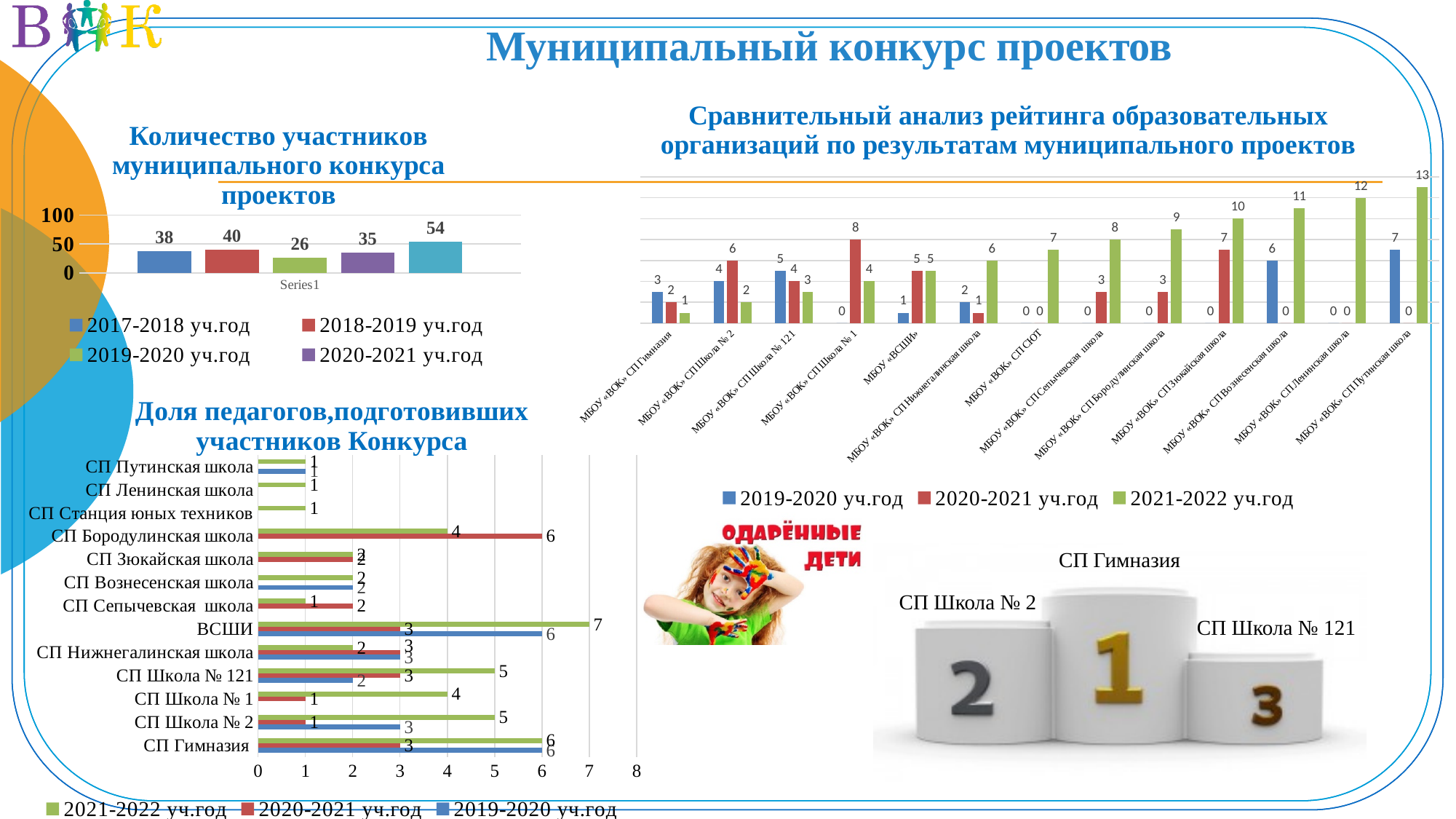
In the chart 'Сравнительный анализ рейтинга образовательных организаций', which organisation has the highest value for 2021-2022 уч.год? МБОУ «ВОК» СП Путинская школа In the chart 'Количество участников муниципального конкурса проектов', what is the value for 2019-2020 уч.год? 26 In the chart 'Сравнительный анализ рейтинга образовательных организаций', does the 2021-2022 уч.год value rise or fall from left to right across the organisations? rise In the chart 'Доля педагогов, подготовивших участников Конкурса', what is the value for ВСШИ in 2021-2022 уч.год? 7 In the chart 'Доля педагогов, подготовивших участников Конкурса', what is the value for СП Бородулинская школа in 2020-2021 уч.год? 6 In the chart 'Количество участников муниципального конкурса проектов', what is the value for 2018-2019 уч.год? 40 In the chart 'Доля педагогов, подготовивших участников Конкурса', which is larger for СП Школа № 2: the 2021-2022 уч.год value or the 2019-2020 уч.год value? 2021-2022 уч.год In the chart 'Сравнительный анализ рейтинга образовательных организаций', what is the value for МБОУ «ВОК» СП Школа № 1 in 2020-2021 уч.год? 8 In the chart 'Количество участников муниципального конкурса проектов', what is the difference between the values for 2018-2019 уч.год and 2017-2018 уч.год? 2 What type of chart is 'Доля педагогов, подготовивших участников Конкурса'? bar chart In the chart 'Сравнительный анализ рейтинга образовательных организаций', how many series does the legend list? 3 In the chart 'Количество участников муниципального конкурса проектов', what is the highest value shown? 54